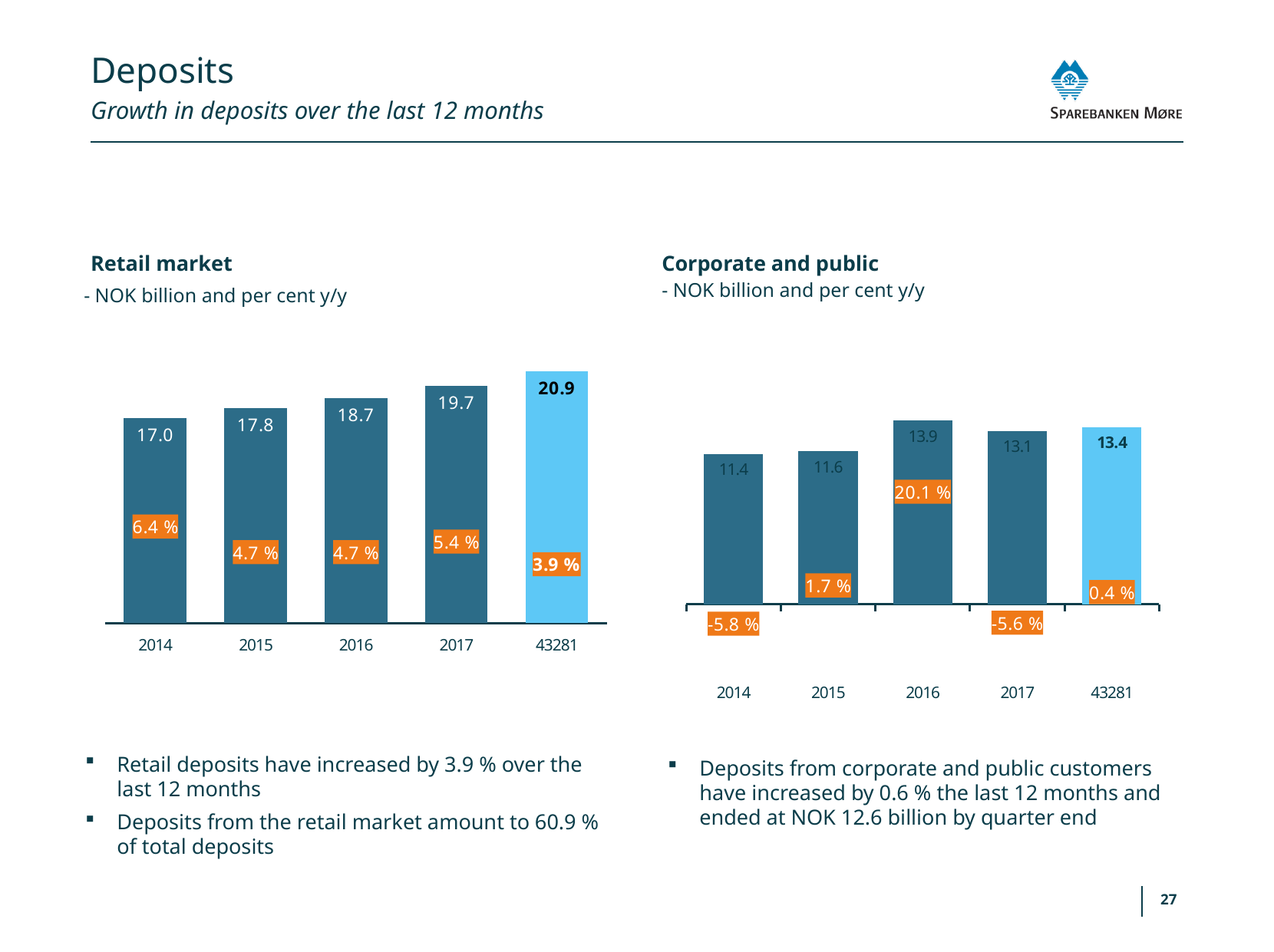
In the Corporate and public chart, which year has the highest y/y growth percentage? 2016 In the Retail market chart, what is the difference in deposits between 2017 and 2014? 2.7 In the Corporate and public chart, what is the y/y growth percentage shown for 2017? -5.6 % In the Retail market chart, which year has the highest deposit value? 43281 In the Corporate and public chart, which year has the lowest deposit value? 2014 In the Retail market chart, how many bars are plotted? 5 In the Corporate and public chart, is the deposit value for 2016 or 2017 larger? 2016 In the Retail market chart, do the deposit values rise or fall from 2014 to the last bar? rise In the Retail market chart, what is the deposit value (NOK billion) for 2016? 18.7 What type of chart is the Retail market chart? bar chart In the Corporate and public chart, what is the deposit value (NOK billion) for 2016? 13.9 In the Retail market chart, what is the y/y growth percentage shown for 2014? 6.4 %